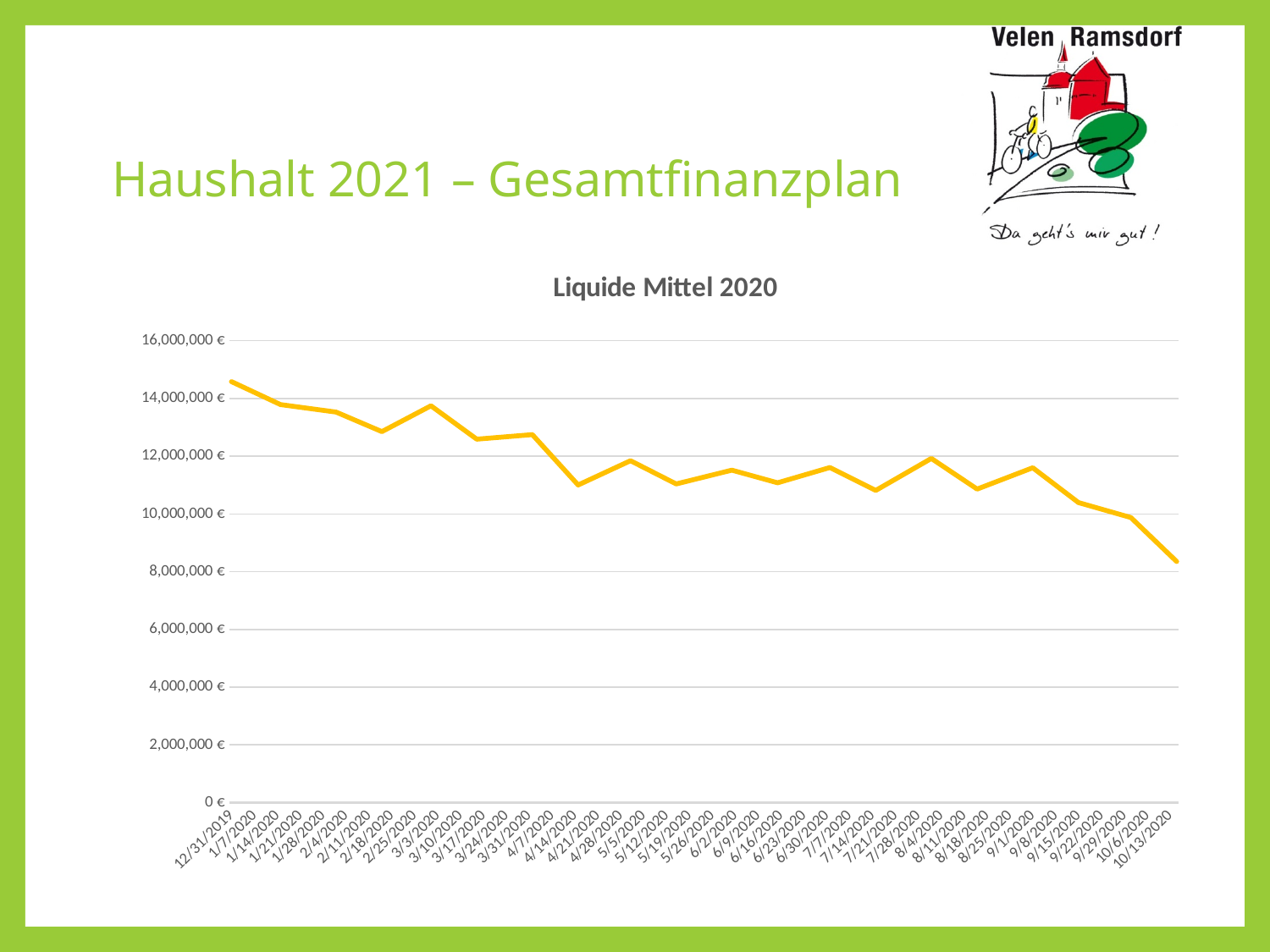
Which date has the highest value? 12/31/2019 What is the highest value shown on the y axis? 16,000,000 € What is the title of the chart? Liquide Mittel 2020 Is the value for 3/3/2020 greater or less than 14,000,000 €? less How many data points are plotted along the x axis? 20 Do the values generally rise or fall from 12/31/2019 to 10/13/2020? fall Is the value for 12/31/2019 greater or less than 14,000,000 €? greater Is the value for 10/13/2020 greater or less than 10,000,000 €? less Which is larger, the value for 12/31/2019 or the value for 10/13/2020? 12/31/2019 Which date has the lowest value? 10/13/2020 What kind of chart is shown on the slide? line chart